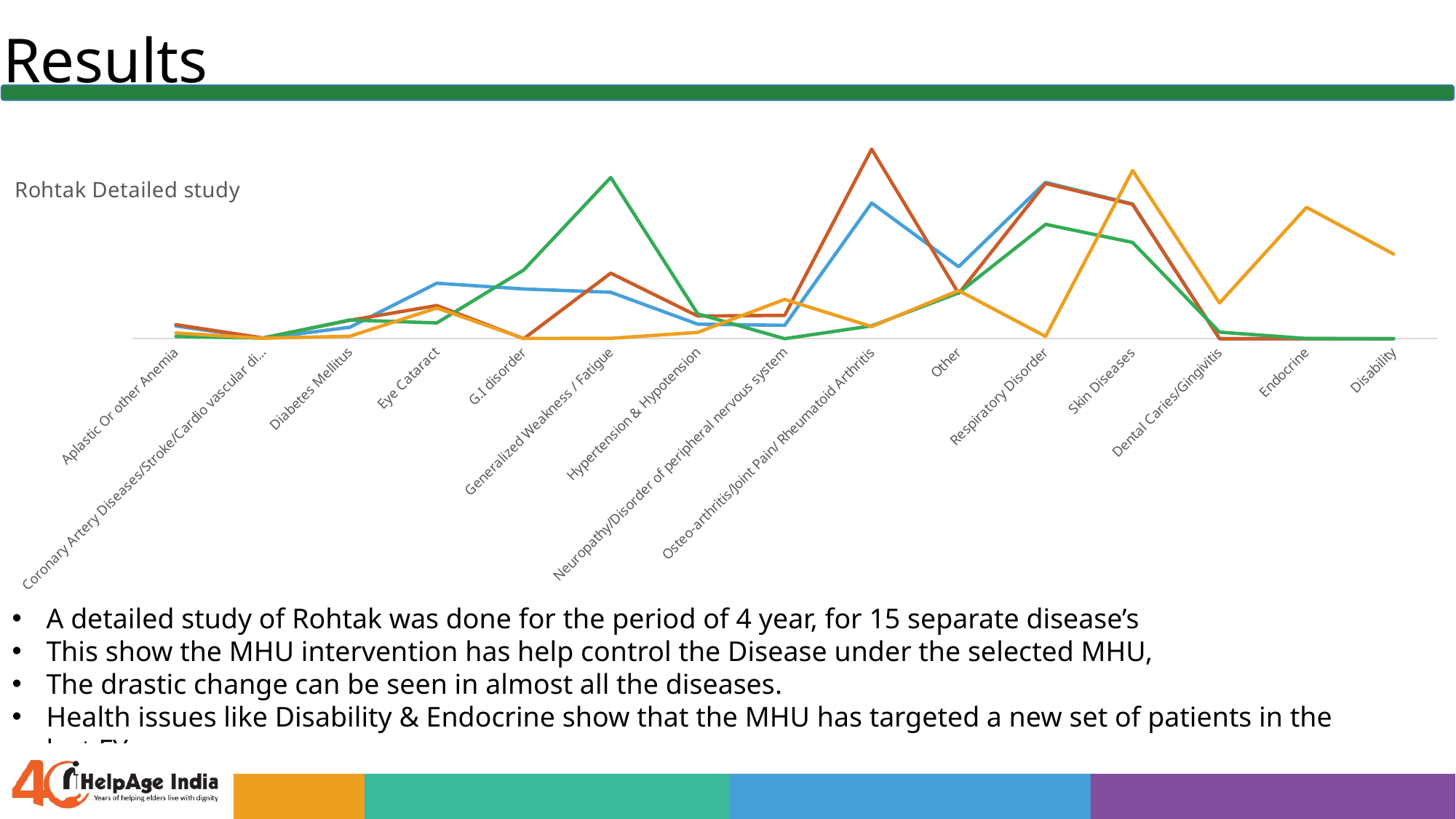
Does the yellow line rise or fall from Dental Caries/Gingivitis to Endocrine? rise At which category does the yellow line reach its highest value? Skin Diseases What is the title of the chart? Rohtak Detailed study At Disability, which line is higher: the yellow line or the green line? yellow line How many lines are plotted on the chart? 4 At Generalized Weakness / Fatigue, which line is higher: the green line or the red line? green line Which line has the highest value at Endocrine? yellow line At which category does the blue line reach its highest value? Respiratory Disorder What kind of chart is shown on the slide? line chart At which category does the red line reach its highest value? Osteo-arthritis/Joint Pain/ Rheumatoid Arthritis How many disease categories are shown along the x axis of the chart? 15